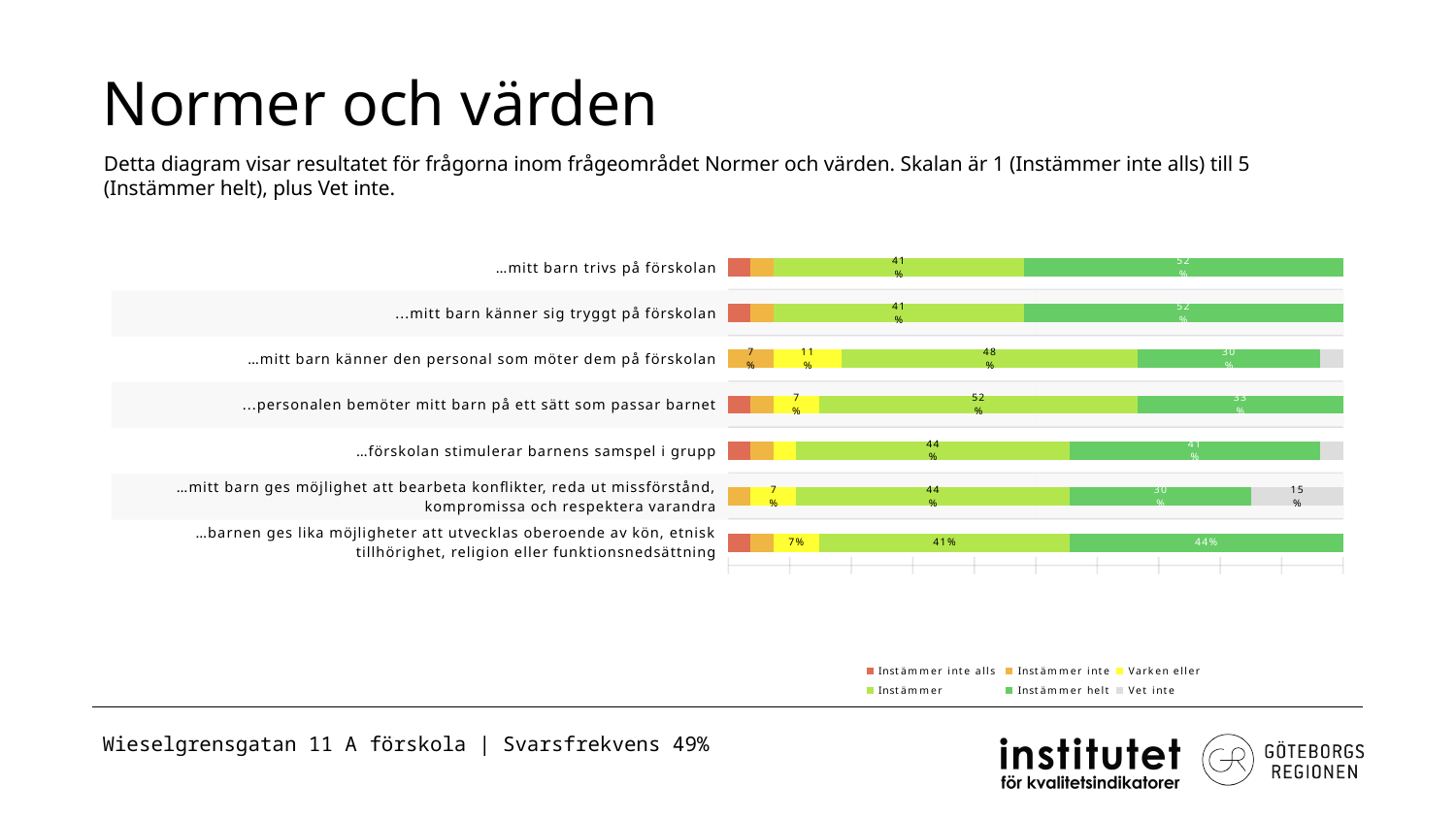
What is the 'Instämmer helt' value for '…personalen bemöter mitt barn på ett sätt som passar barnet'? 33% How many series does the legend list? 6 Which category has the highest 'Instämmer' value? …personalen bemöter mitt barn på ett sätt som passar barnet What is the difference in 'Instämmer helt' between '…mitt barn trivs på förskolan' and '…mitt barn känner den personal som möter dem på förskolan'? 22 percentage points What kind of chart is shown on the slide? Stacked bar chart What is the 'Vet inte' value for '…mitt barn ges möjlighet att bearbeta konflikter, reda ut missförstånd, kompromissa och respektera varandra'? 15% For '…förskolan stimulerar barnens samspel i grupp', which is larger: 'Instämmer' or 'Instämmer helt'? Instämmer What is the 'Instämmer' value for '…mitt barn känner den personal som möter dem på förskolan'? 48% How many question categories are plotted in the chart? 7 What is the 'Instämmer helt' value for '…barnen ges lika möjligheter att utvecklas oberoende av kön, etnisk tillhörighet, religion eller funktionsnedsättning'? 44% What colour represents 'Vet inte' in the legend? Grey What is the 'Instämmer helt' value for '…mitt barn trivs på förskolan'? 52%